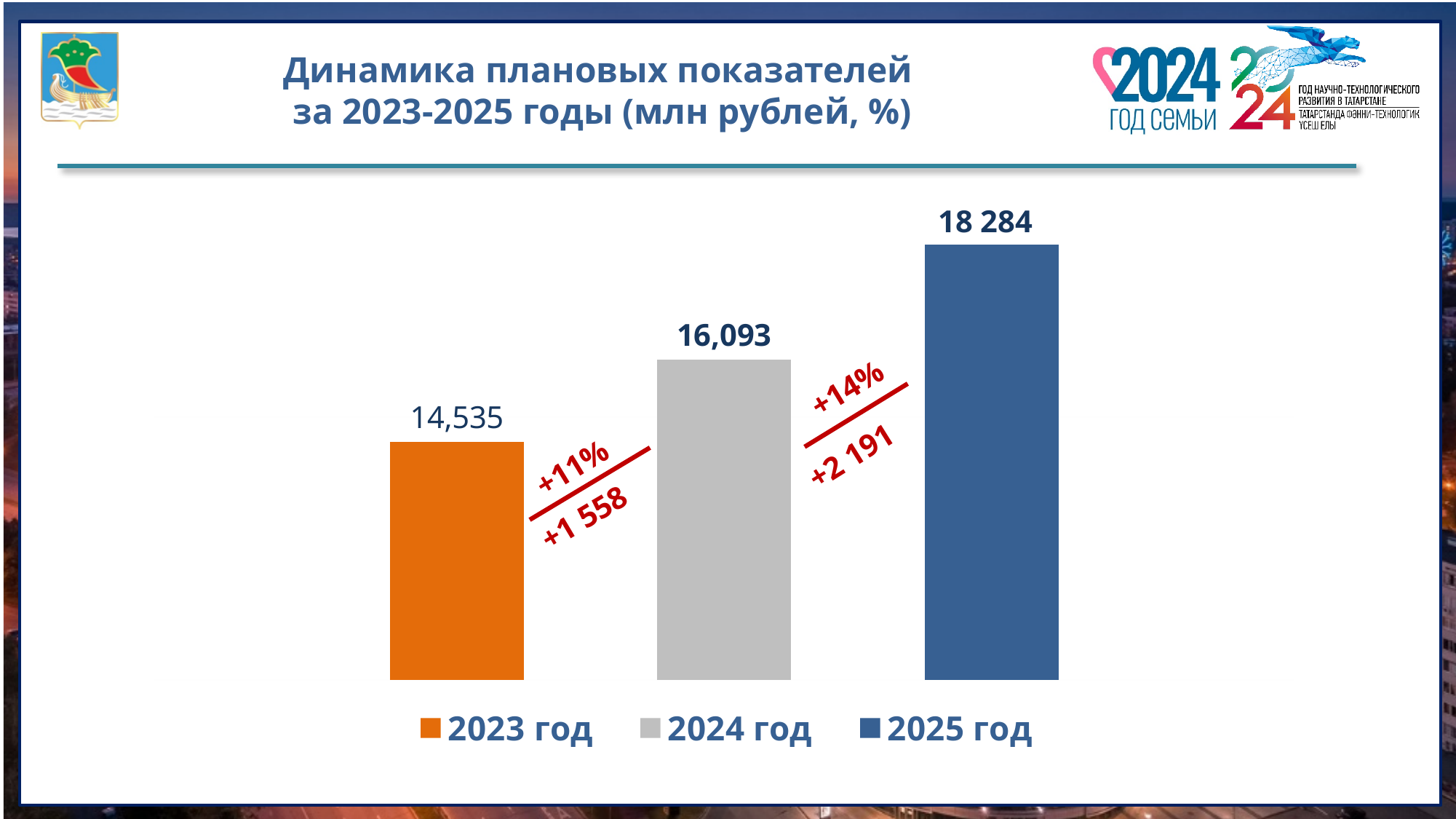
What percentage growth is shown between 2024 год and 2025 год? +14% How many entries does the legend list? 3 Which is larger, the value for 2024 год or the value for 2025 год? 2025 год What is the value shown for 2024 год? 16,093 Which year has the highest value? 2025 год What is the increase from 2024 год to 2025 год, as labelled on the chart? +2 191 What is the increase from 2023 год to 2024 год, as labelled on the chart? +1 558 Do the values rise or fall from 2023 год to 2025 год? rise How many bars are plotted on the chart? 3 What is the value shown for 2025 год? 18 284 What is the value shown for 2023 год? 14,535 Which year has the lowest value? 2023 год